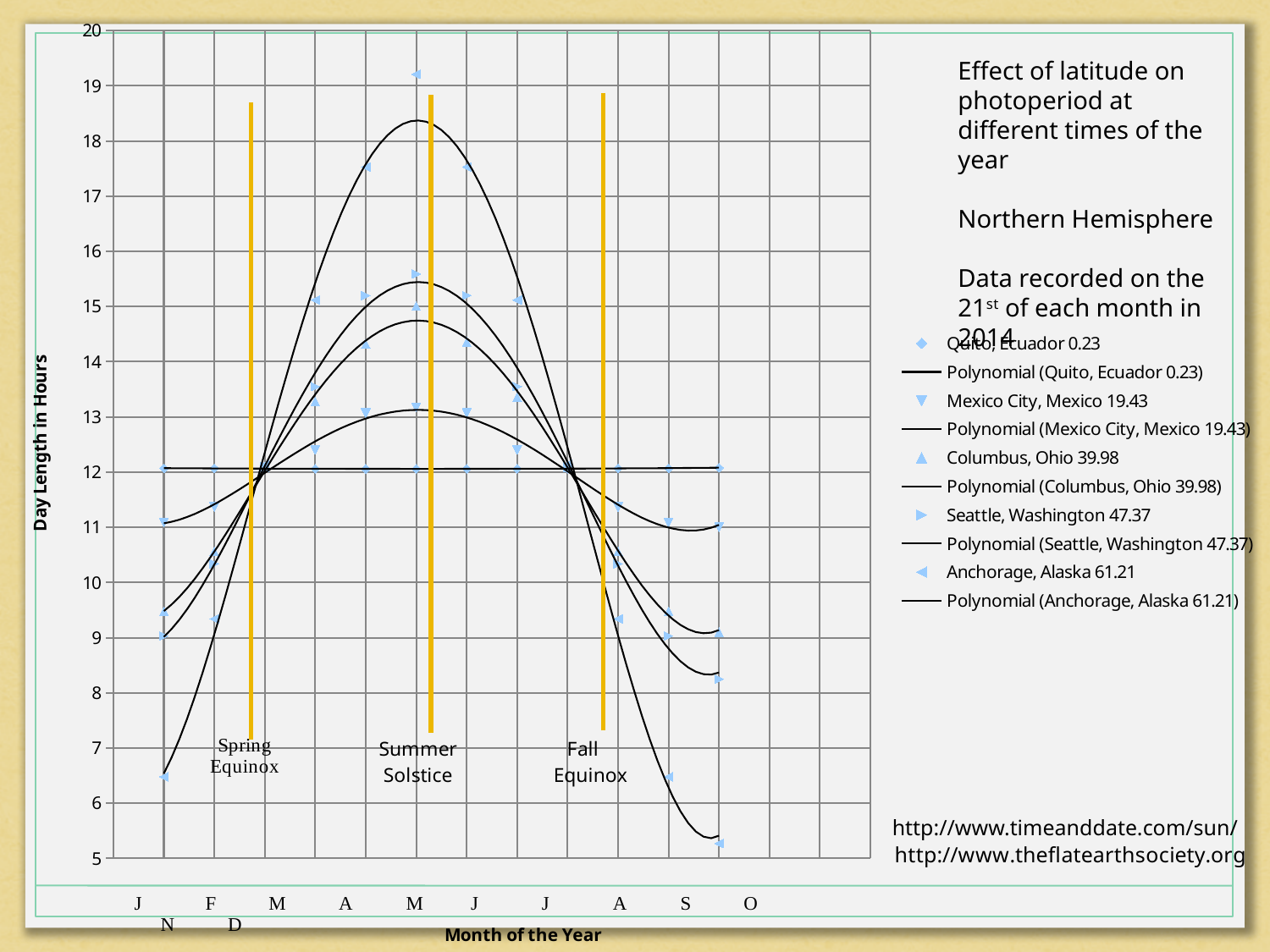
Is the peak day length for Seattle, Washington greater or less than 15 hours? greater How many cities are plotted on the chart? 5 How many entries does the chart legend list? 10 Does the day length for Anchorage, Alaska rise or fall from June to December? fall Is the December day length for Columbus, Ohio greater or less than 10 hours? less Which city has the longest day length around the Summer Solstice? Anchorage, Alaska 61.21 What kind of chart is shown on the slide? scatter chart with polynomial trendlines Around the Summer Solstice, which city has the longer day: Seattle, Washington or Mexico City, Mexico? Seattle, Washington Which city has the shortest day length in December? Anchorage, Alaska 61.21 Is the peak day length for Anchorage, Alaska greater or less than 18 hours? greater What is the label on the y-axis of the chart? Day Length in Hours